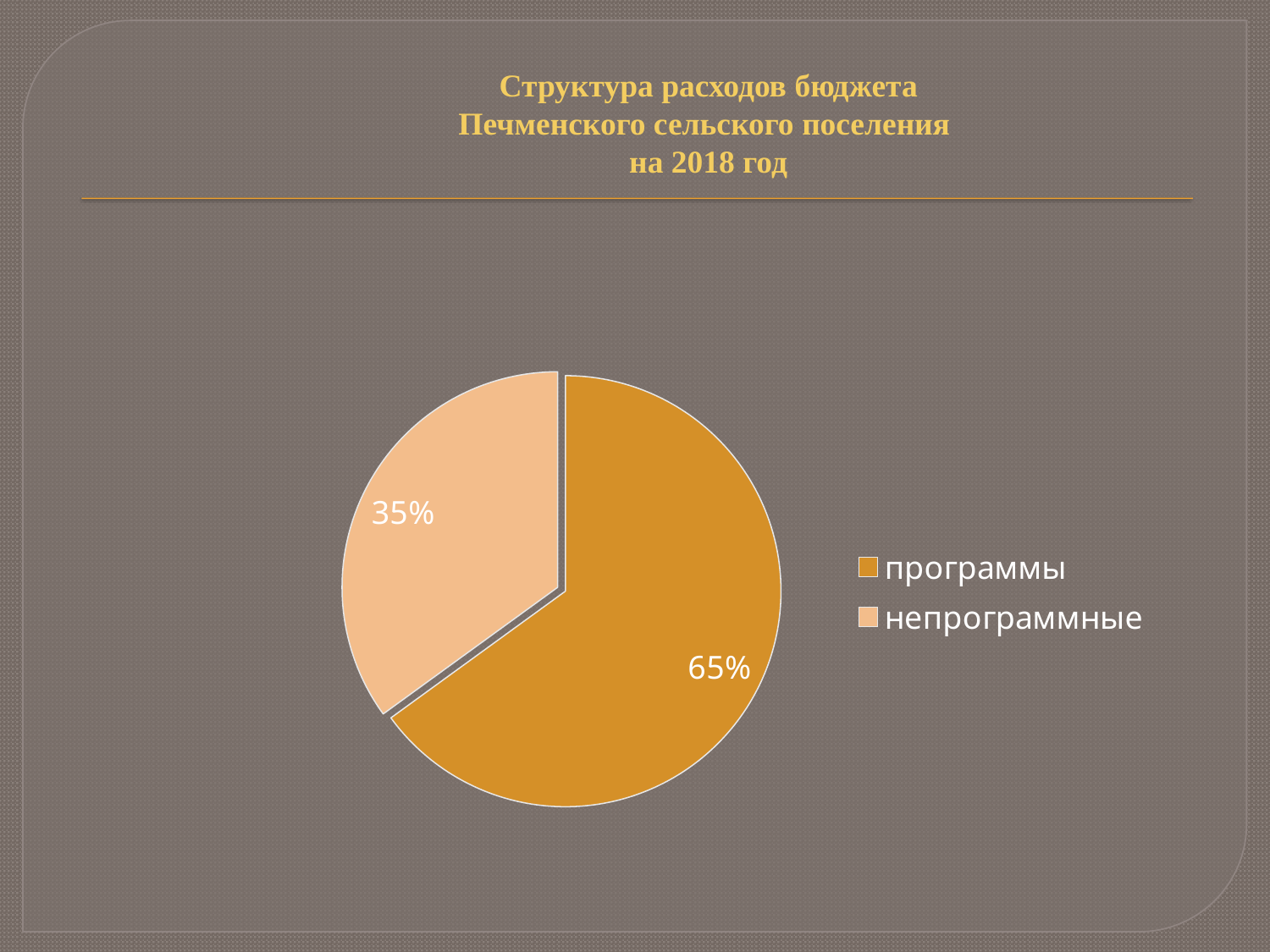
How many entries does the legend list? 2 Which legend entry is shown in the lighter peach colour? непрограммные Which slice is the smallest? непрограммные What is the difference in percentage points between the 'программы' and 'непрограммные' slices? 30 percentage points Which is larger, the 'программы' slice or the 'непрограммные' slice? программы Which slice is the largest? программы How many slices does the pie chart have? 2 What kind of chart is shown on the slide? pie chart What share of the pie does the 'непрограммные' slice represent? 35% What share of the pie does the 'программы' slice represent? 65% What is the title of the chart on the slide? Структура расходов бюджета Печменского сельского поселения на 2018 год